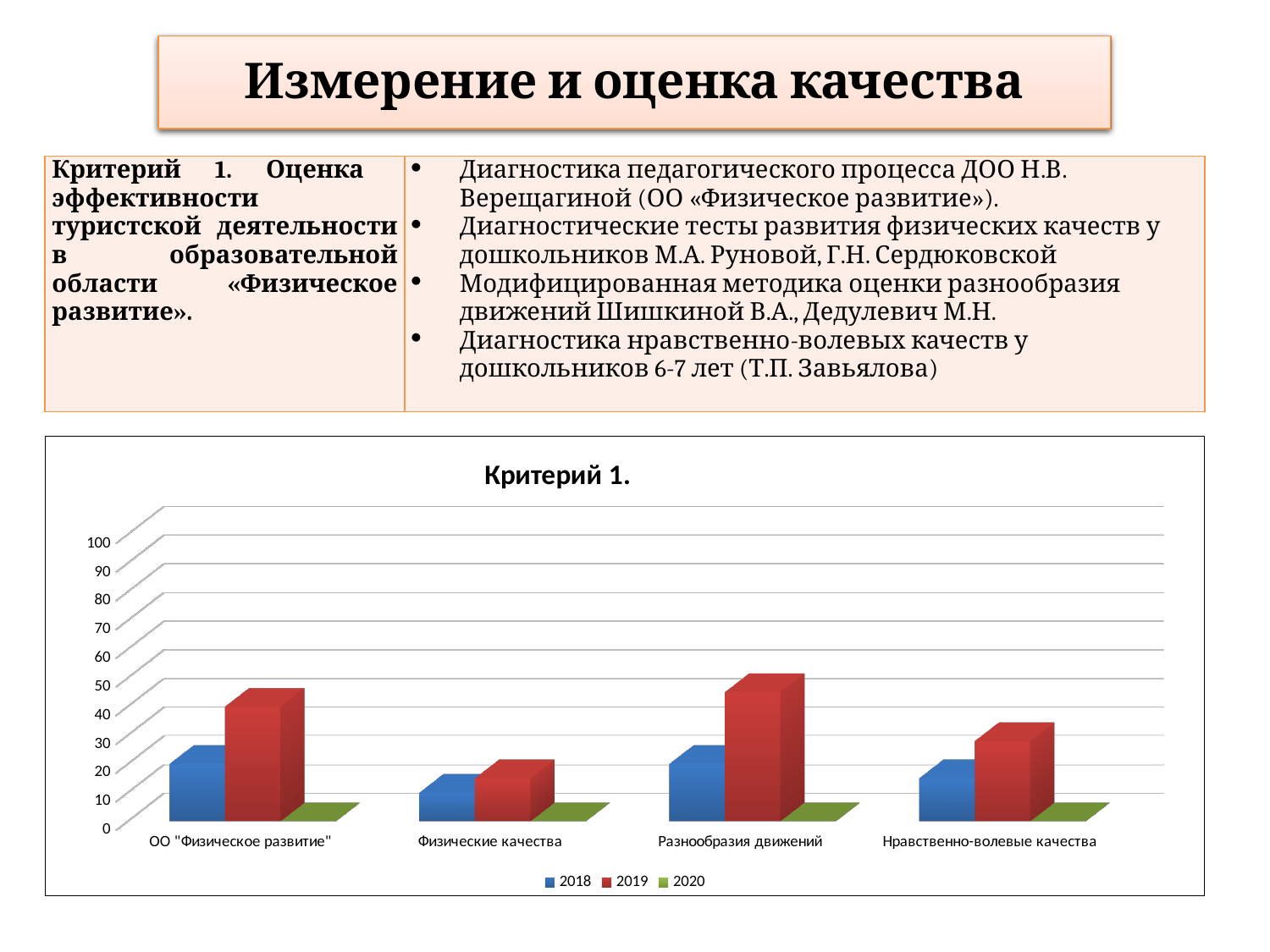
For the 2019 series, which category has the lowest bar? Физические качества For the 2019 series, which category has the highest bar? Разнообразия движений How many series does the chart legend list? 3 What kind of chart is shown on the slide? bar chart Is the 2018 value for ОО "Физическое развитие" greater or less than 40? less Is the 2019 value for Физические качества greater or less than 30? less In the category Разнообразия движений, which is larger: the 2018 value or the 2019 value? 2019 How many categories are shown on the x axis of the chart? 4 What is the title of the chart? Критерий 1. Is the 2019 value for Разнообразия движений greater or less than 40? greater For the 2018 series, which category has the lowest bar? Физические качества Which years are listed in the chart legend? 2018, 2019, 2020